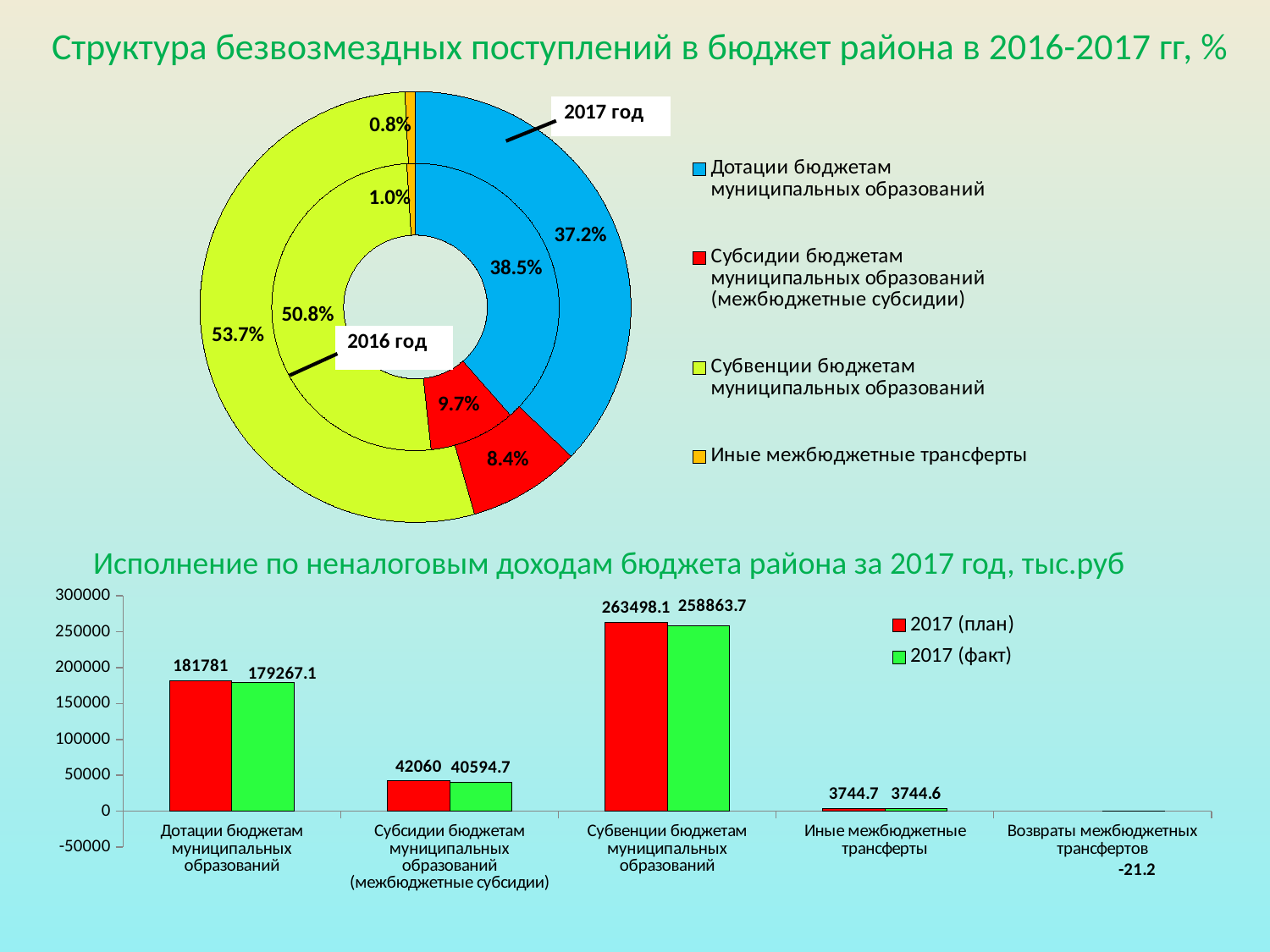
In the top doughnut chart, what share did Субвенции бюджетам муниципальных образований have in 2017? 53.7% In the bottom bar chart, which category has the highest 2017 (факт) value? Субвенции бюджетам муниципальных образований What type of chart is the bottom chart on the slide? Bar chart How many legend entries does the top doughnut chart list? 4 In the bottom bar chart, what is the 2017 (план) value for Субвенции бюджетам муниципальных образований? 263498.1 In the top doughnut chart, what share did Дотации бюджетам муниципальных образований have in 2016? 38.5% How many categories are shown on the x axis of the bottom bar chart? 5 In the top doughnut chart, what share did Иные межбюджетные трансферты have in 2017? 0.8% In the bottom bar chart, what is the 2017 (факт) value for Дотации бюджетам муниципальных образований? 179267.1 In the top doughnut chart, by how many percentage points did the share of Субсидии бюджетам муниципальных образований change from 2016 (9.7%) to 2017 (8.4%)? 1.3 percentage points In the bottom bar chart, what is the difference between the 2017 (план) and 2017 (факт) values for Субсидии бюджетам муниципальных образований (межбюджетные субсидии)? 1465.3 In the top doughnut chart, which category had the largest share in 2017? Субвенции бюджетам муниципальных образований